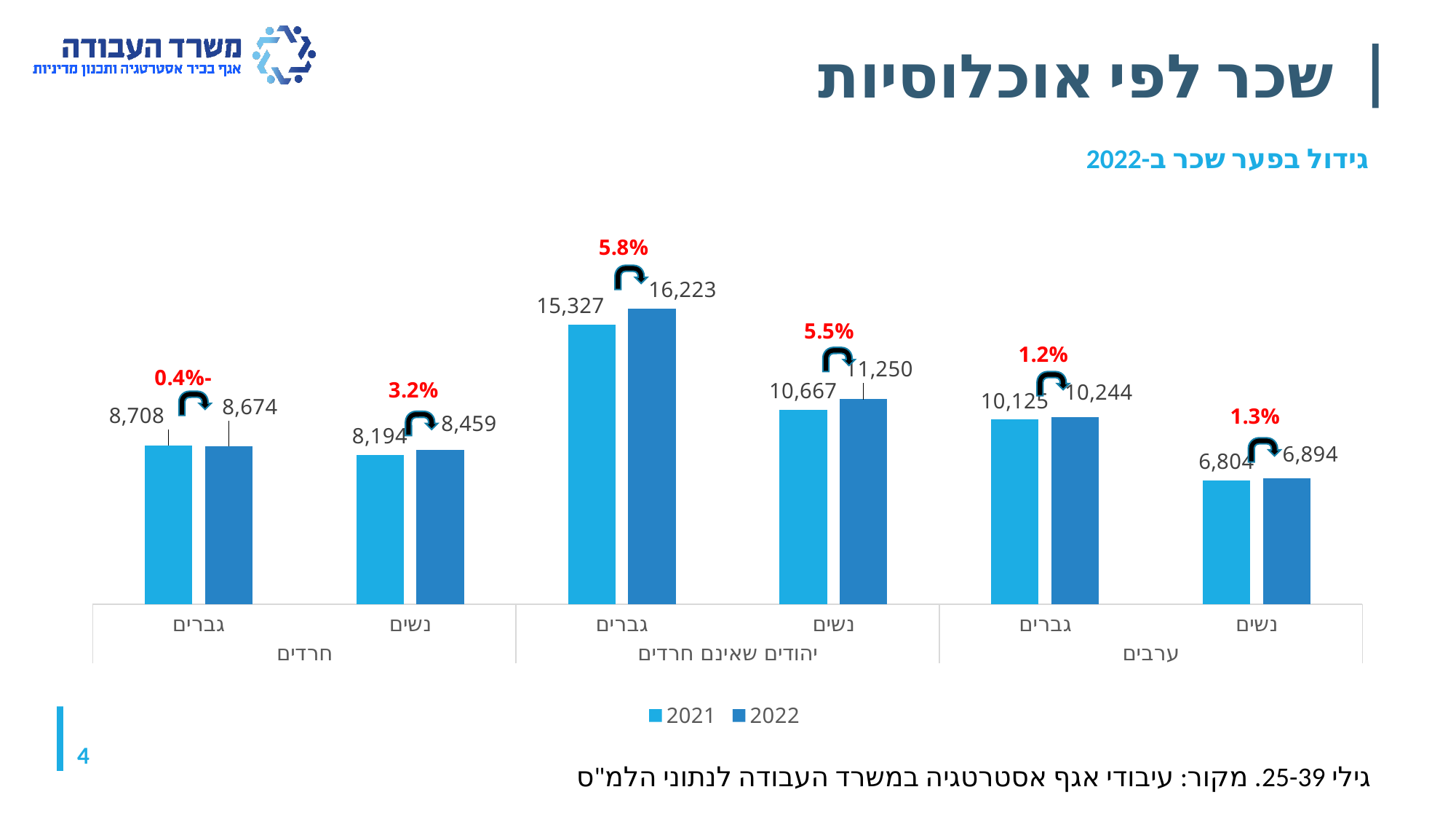
What is the 2021 value for נשים in the חרדים group? 8,194 What percentage change is shown above the bars for גברים in the ערבים group? 1.2% What is the 2021 value for נשים in the ערבים group? 6,804 Which population group is the only one where the value fell from 2021 to 2022? גברים, חרדים Which is larger: the 2022 value for גברים in the חרדים group or the 2022 value for נשים in the ערבים group? גברים in the חרדים group What is the difference between the 2022 and 2021 values for גברים in the יהודים שאינם חרדים group? 896 What kind of chart is shown on the slide? Bar chart Which group and gender has the lowest 2021 value? נשים, ערבים What is the difference between the 2022 and 2021 values for נשים in the יהודים שאינם חרדים group? 583 Which group and gender has the highest 2022 value? גברים, יהודים שאינם חרדים How many series does the legend list? 2 What is the 2022 value for גברים in the יהודים שאינם חרדים group? 16,223